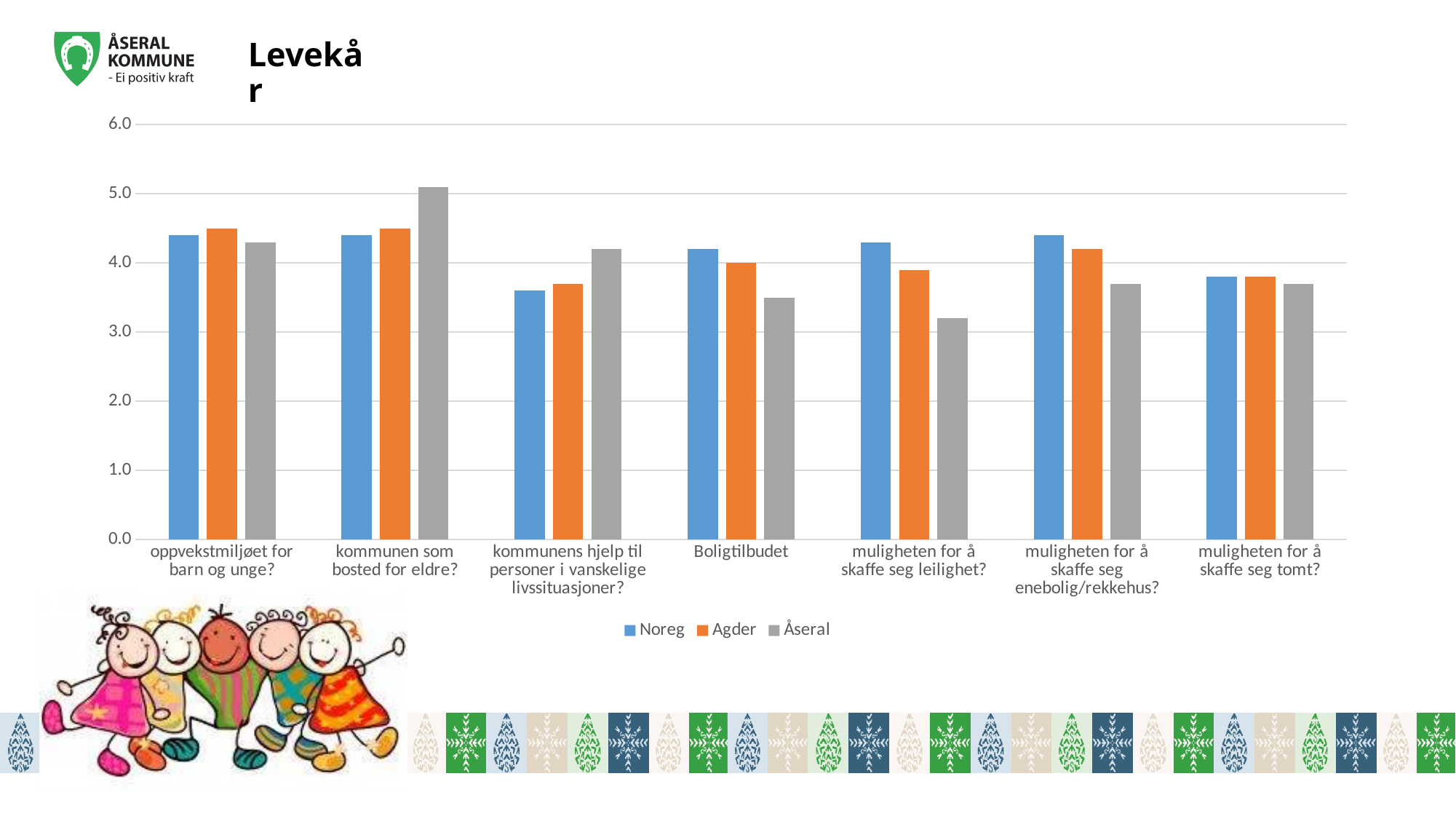
What kind of chart is shown on the slide? bar chart Is the Noreg value for 'kommunens hjelp til personer i vanskelige livssituasjoner?' greater or less than 4.0? less How many series does the legend list? 3 What is the title of the chart? Levekår For which category is the Åseral bar highest? kommunen som bosted for eldre? For 'kommunen som bosted for eldre?', which is larger: the Noreg value or the Åseral value? Åseral How many categories are shown on the x axis? 7 For 'muligheten for å skaffe seg leilighet?', which is larger: the Noreg value or the Åseral value? Noreg For which category is the Åseral bar lowest? muligheten for å skaffe seg leilighet? Is the Åseral value for 'Boligtilbudet' greater or less than 4.0? less Which series is shown in grey in the legend? Åseral Is the Noreg value for 'oppvekstmiljøet for barn og unge?' greater or less than 4.0? greater